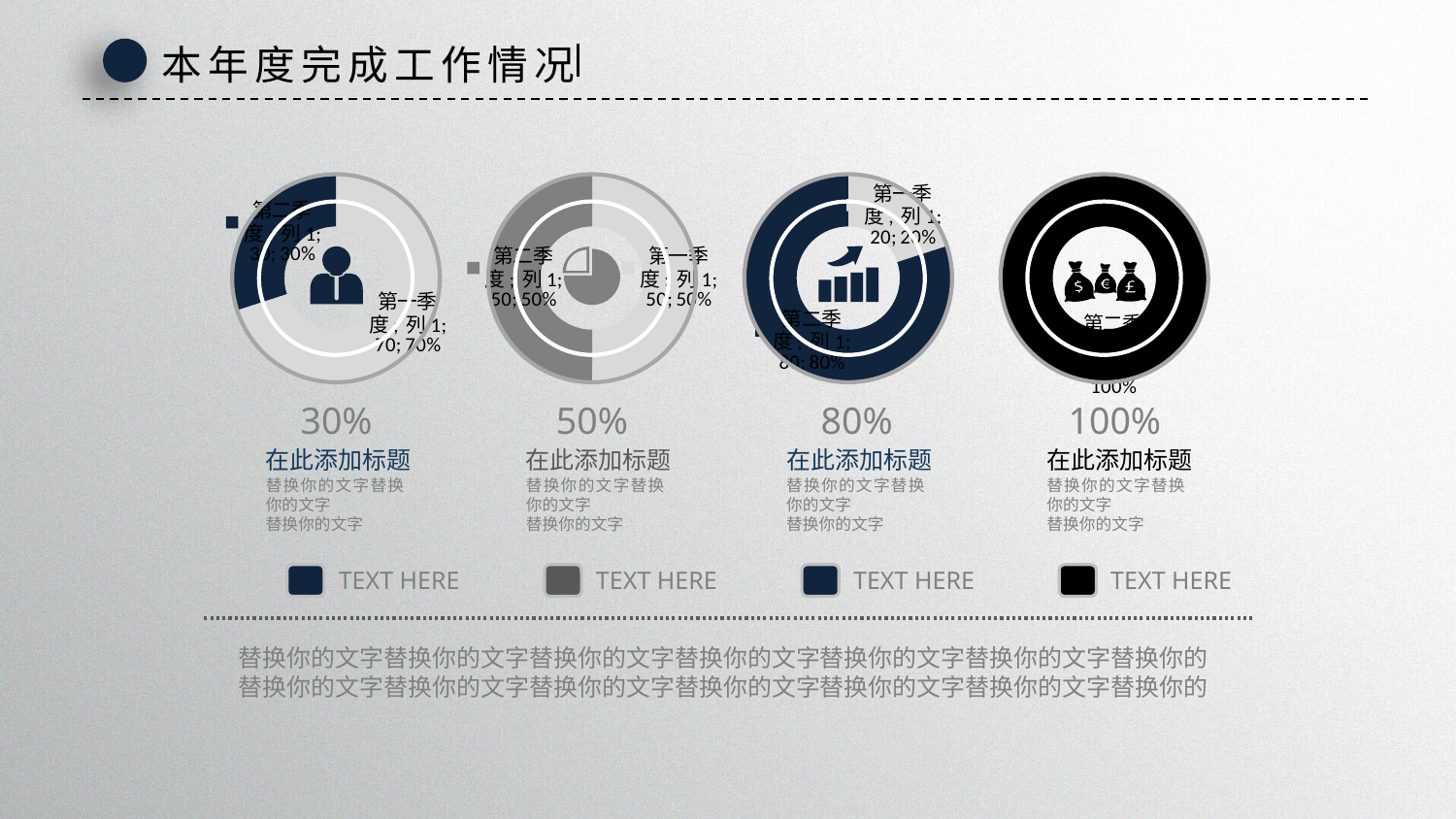
How many doughnut charts are shown on the slide? 4 In the third chart from the left, what is the value for 第二季度? 80 What kind of chart is used for each of the four graphics on the slide? Doughnut (pie) chart In the leftmost chart, what percentage share does 第二季度 have? 30% In the second chart from the left, what is the value for 第一季度? 50 In the second chart from the left, what percentage share does 第二季度 have? 50% In the third chart from the left, what percentage share does 第一季度 have? 20% In the leftmost chart, what is the difference between the 第一季度 and 第二季度 values? 40 What is the title of the slide? 本年度完成工作情况 In the third chart from the left, which is larger, 第一季度 or 第二季度? 第二季度 In the leftmost chart, what is the value for 第一季度? 70 What percentage is printed below the rightmost chart? 100%